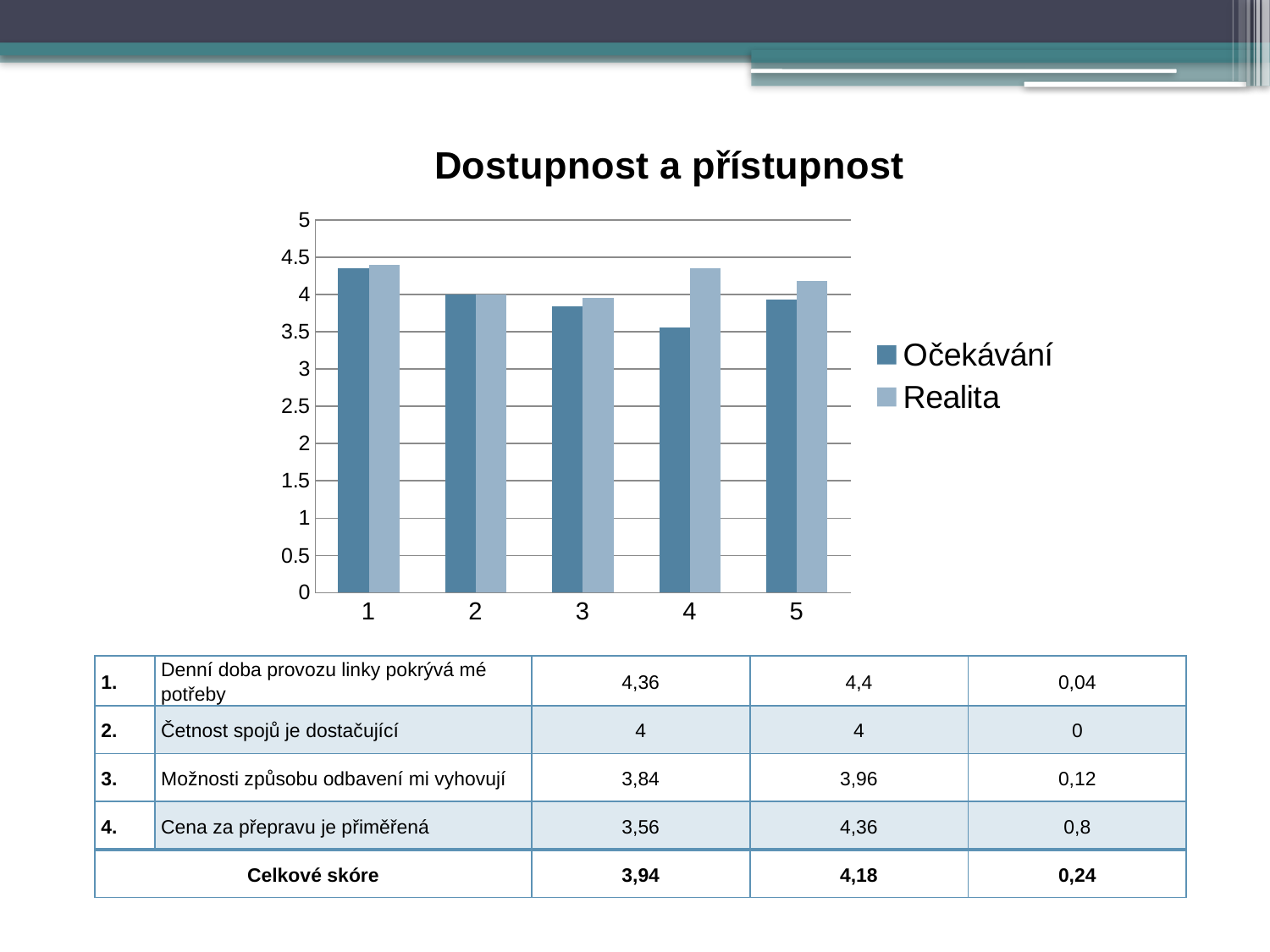
Which category has the highest Očekávání value? 1 What kind of chart is shown on the slide? bar chart Is the Realita value for category 5 greater or less than 4? greater For category 4, which is larger: Očekávání or Realita? Realita What is the difference between the Realita and Očekávání values for category 4? 0,8 What is the Očekávání value for category 2? 4 How many series does the chart legend list? 2 Is the Očekávání value for category 4 greater or less than 4? less What is the title of the chart? Dostupnost a přístupnost How many categories are shown on the x axis of the chart? 5 What is the Realita value for category 4? 4,36 Which category has the lowest Očekávání value? 4